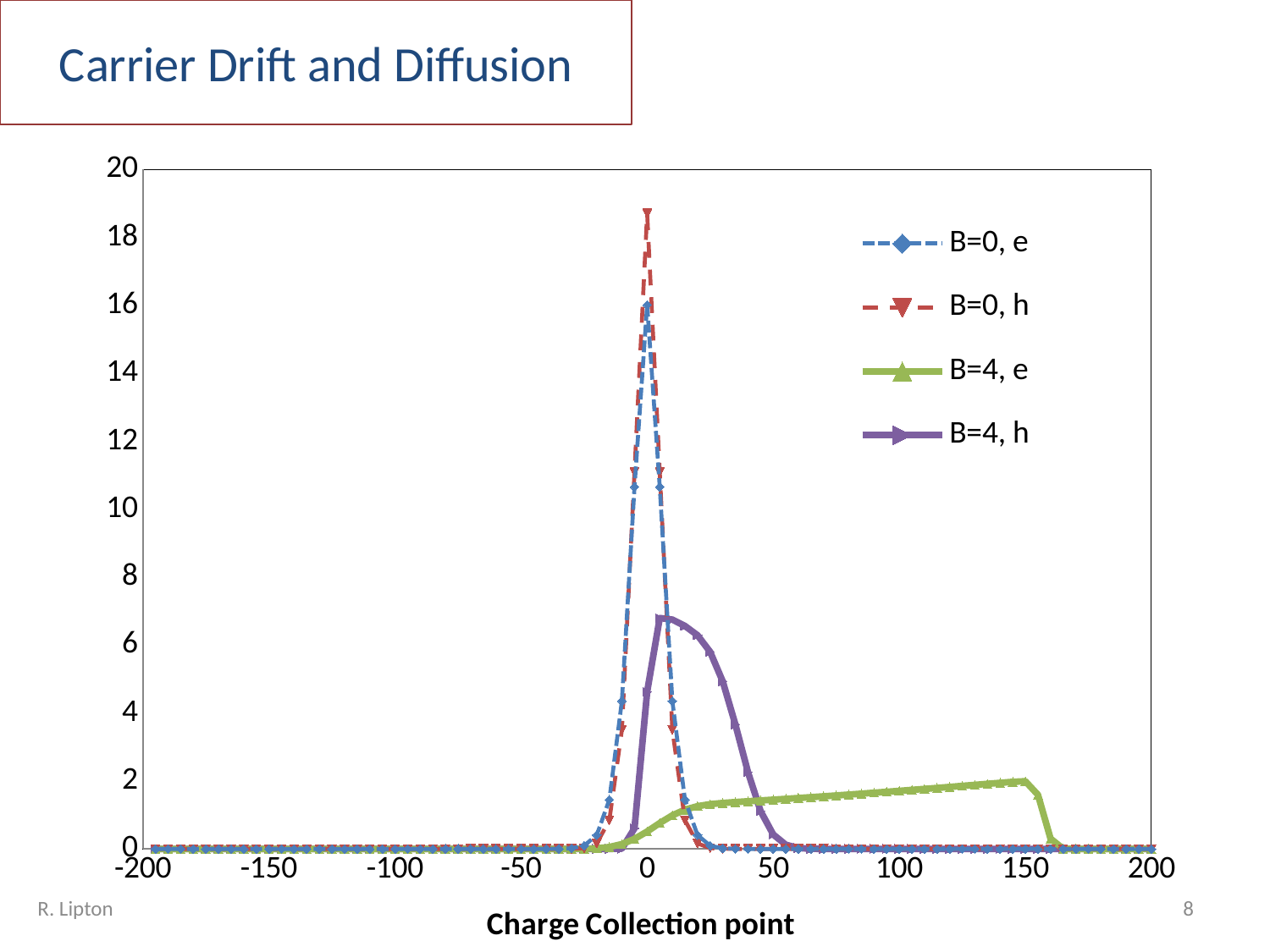
Is the peak value of the B=0, h series greater or less than 16? greater Which series reaches the highest peak value? B=0, h Which series has the lowest peak value? B=4, e Is the peak value of the B=4, h series greater or less than 8? less Is the peak value of the B=0, e series greater or less than 14? greater Which series extends furthest to the right along the x axis before dropping to zero? B=4, e Between x = 50 and x = 150, does the B=4, e series rise or fall? rise What is the title of the x axis? Charge Collection point What kind of chart is shown on the slide? line chart How many series does the legend list? 4 Which series has a higher peak, B=4, h or B=4, e? B=4, h